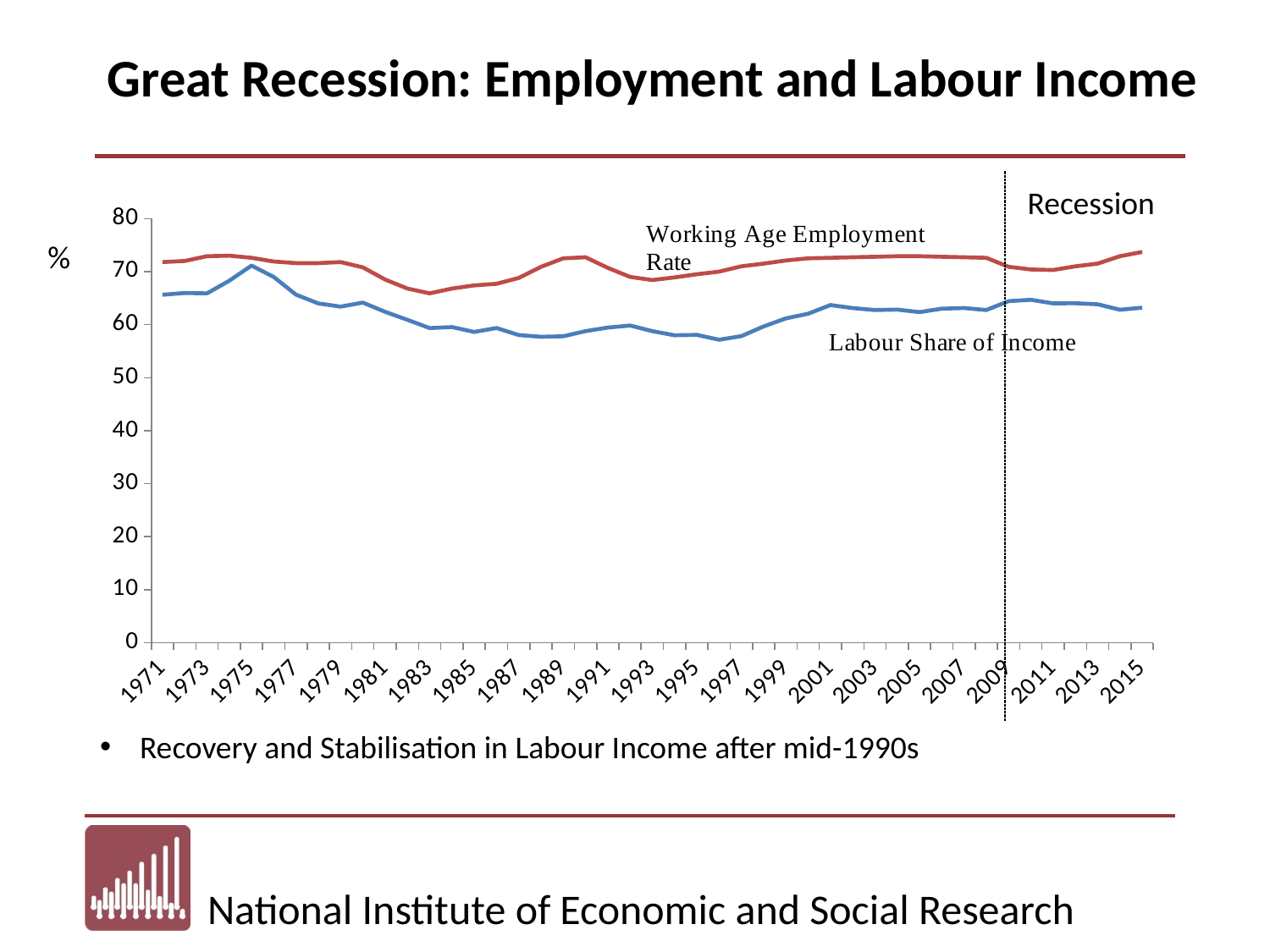
What kind of chart is shown on the slide? line chart What year does the dotted vertical line labelled 'Recession' mark on the x axis? 2009 What is the first year shown on the x axis? 1971 Is the Working Age Employment Rate in 1983 greater or less than 70? less Is the Working Age Employment Rate in 2015 greater or less than 70? greater In which year does the Labour Share of Income reach its highest value? 1975 Is the value of Labour Share of Income in 1997 greater or less than 60? less What is the title of the slide's chart? Great Recession: Employment and Labour Income How many series (lines) are plotted on the chart? 2 Does the Labour Share of Income rise or fall between 1975 and 1983? fall In 1997, which series has the higher value: Working Age Employment Rate or Labour Share of Income? Working Age Employment Rate